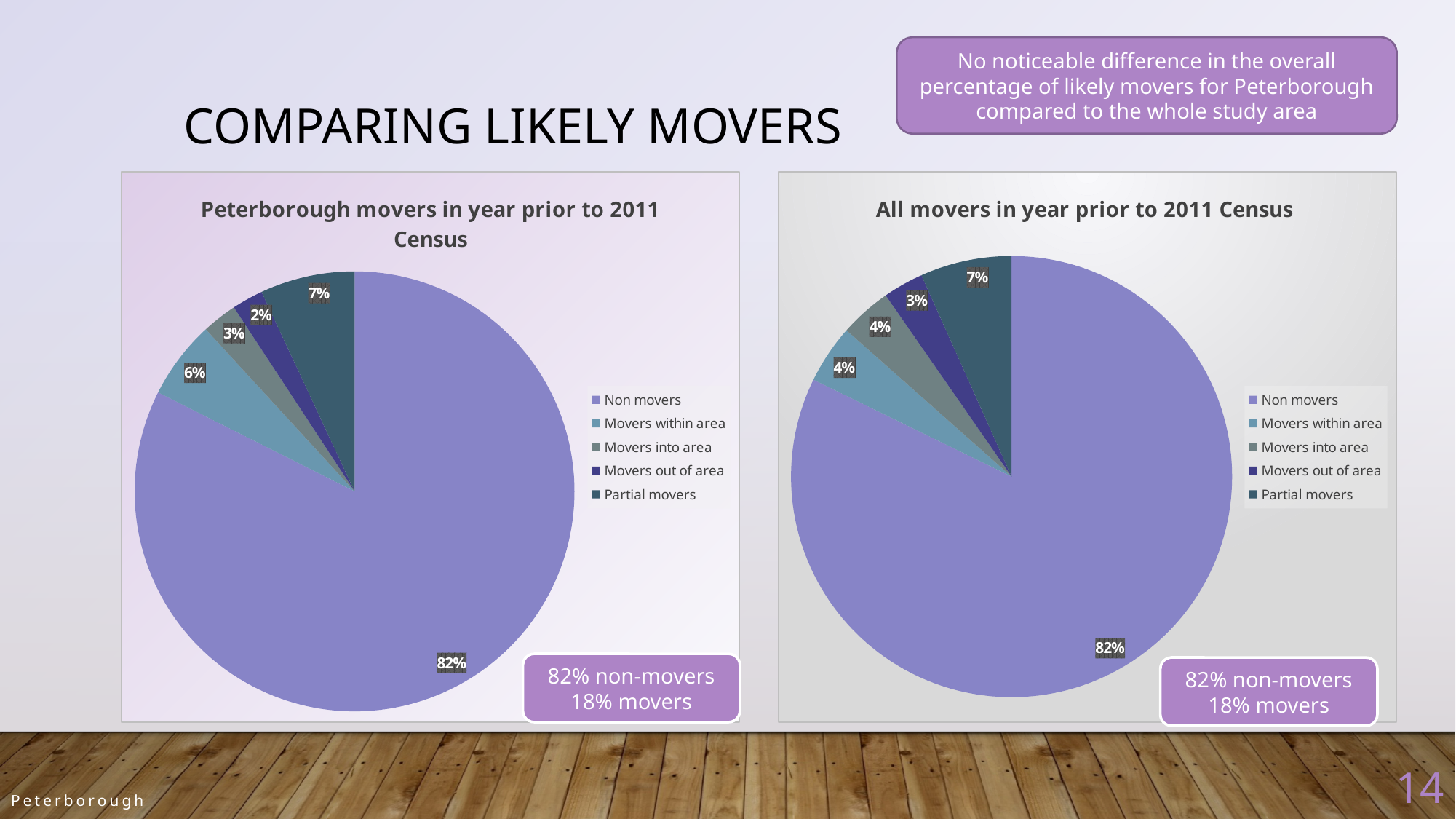
What is the title of the chart on the right side of the slide? All movers in year prior to 2011 Census In the 'All movers in year prior to 2011 Census' chart, what percentage is shown for Partial movers? 7% What type of chart is the 'Peterborough movers in year prior to 2011 Census' chart? Pie chart Which is larger in the 'Peterborough movers in year prior to 2011 Census' chart: Movers within area or Movers into area? Movers within area In the 'Peterborough movers in year prior to 2011 Census' chart, what is the difference between the Partial movers and Movers within area percentages? 1% In the 'All movers in year prior to 2011 Census' chart, what percentage is shown for Movers out of area? 3% In the 'Peterborough movers in year prior to 2011 Census' chart, what percentage is shown for Movers within area? 6% In the 'Peterborough movers in year prior to 2011 Census' chart, what share of the pie is Non movers? 82% In the 'Peterborough movers in year prior to 2011 Census' chart, which category has the smallest slice? Movers out of area In the 'All movers in year prior to 2011 Census' chart, which category has the largest slice? Non movers How many categories does the legend of the 'All movers in year prior to 2011 Census' chart list? 5 In the 'Peterborough movers in year prior to 2011 Census' chart, what percentage is shown for Movers out of area? 2%